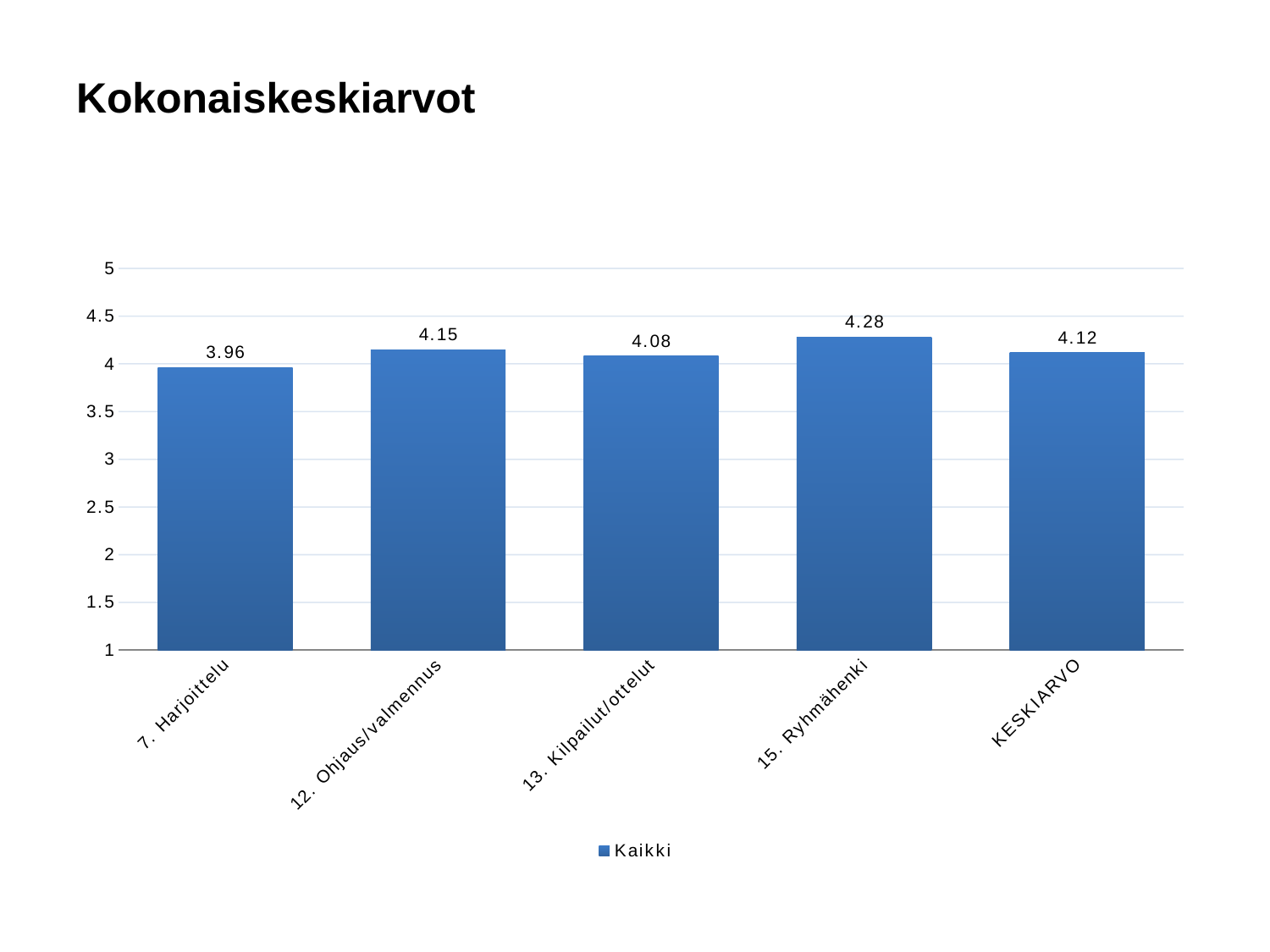
What is the value for 7. Harjoittelu? 3.96 What is the title of the slide? Kokonaiskeskiarvot What is the difference between the values for 15. Ryhmähenki and 7. Harjoittelu? 0.32 How many series does the legend list? 1 What is the value for 13. Kilpailut/ottelut? 4.08 Which category has the highest value? 15. Ryhmähenki What kind of chart is shown on the slide? Bar chart How many categories are shown on the x axis? 5 What is the value for KESKIARVO? 4.12 Which is larger, the value for 12. Ohjaus/valmennus or the value for 13. Kilpailut/ottelut? 12. Ohjaus/valmennus Which category has the lowest value? 7. Harjoittelu What is the value for 12. Ohjaus/valmennus? 4.15